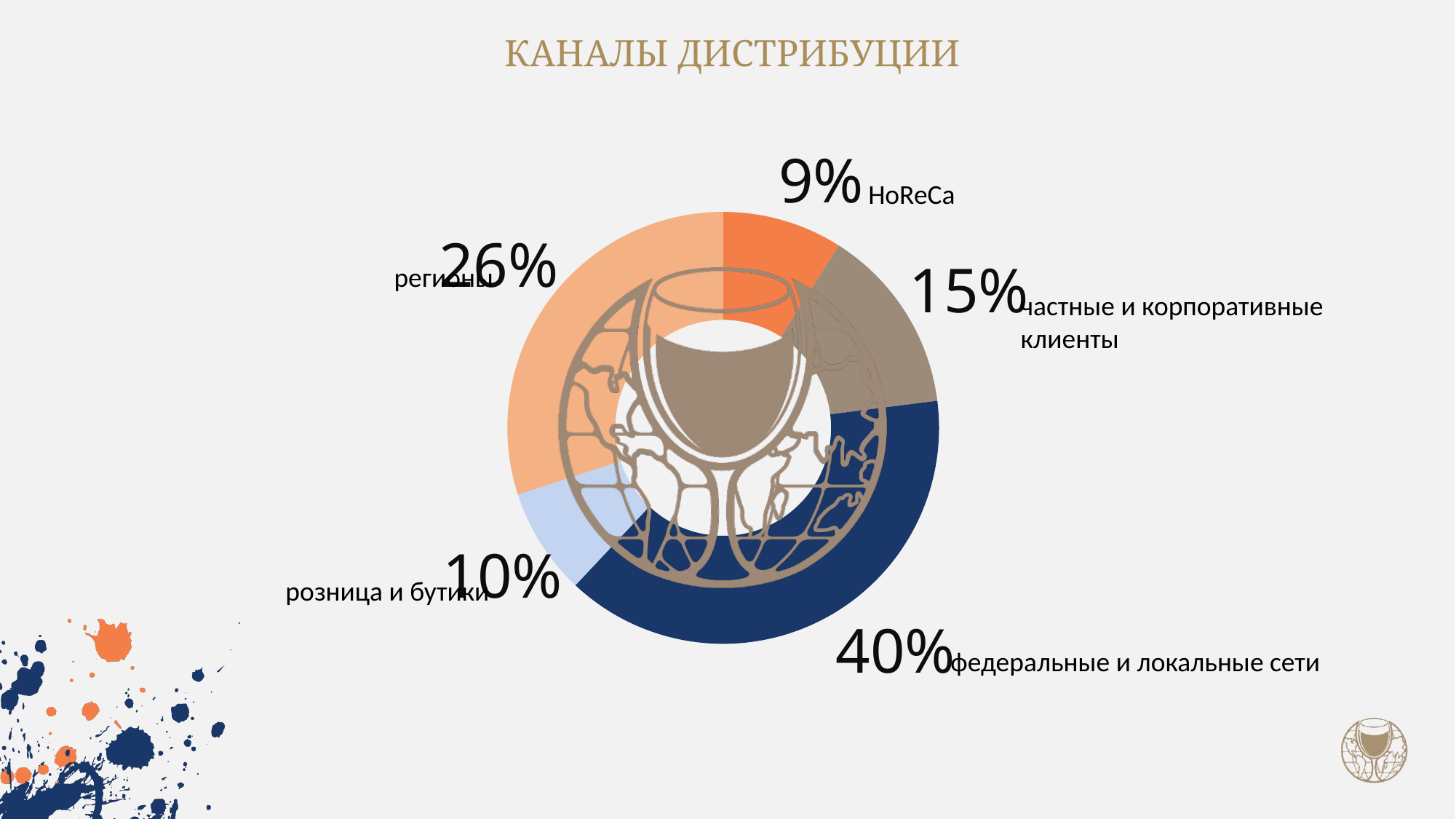
Which distribution channel has the smallest share? HoReCa What is the title of the slide? КАНАЛЫ ДИСТРИБУЦИИ Which distribution channel has the largest share? федеральные и локальные сети What percentage is shown for частные и корпоративные клиенты? 15% Which is larger: the share for частные и корпоративные клиенты or the share for розница и бутики? частные и корпоративные клиенты What share of distribution channels does HoReCa account for? 9% How many distribution channels are shown in the chart? 5 What type of chart is used on this slide? pie chart (donut) What percentage is shown for регионы? 26% What is the difference in percentage points between федеральные и локальные сети and регионы? 14 What percentage is shown for розница и бутики? 10% What percentage is shown for федеральные и локальные сети? 40%